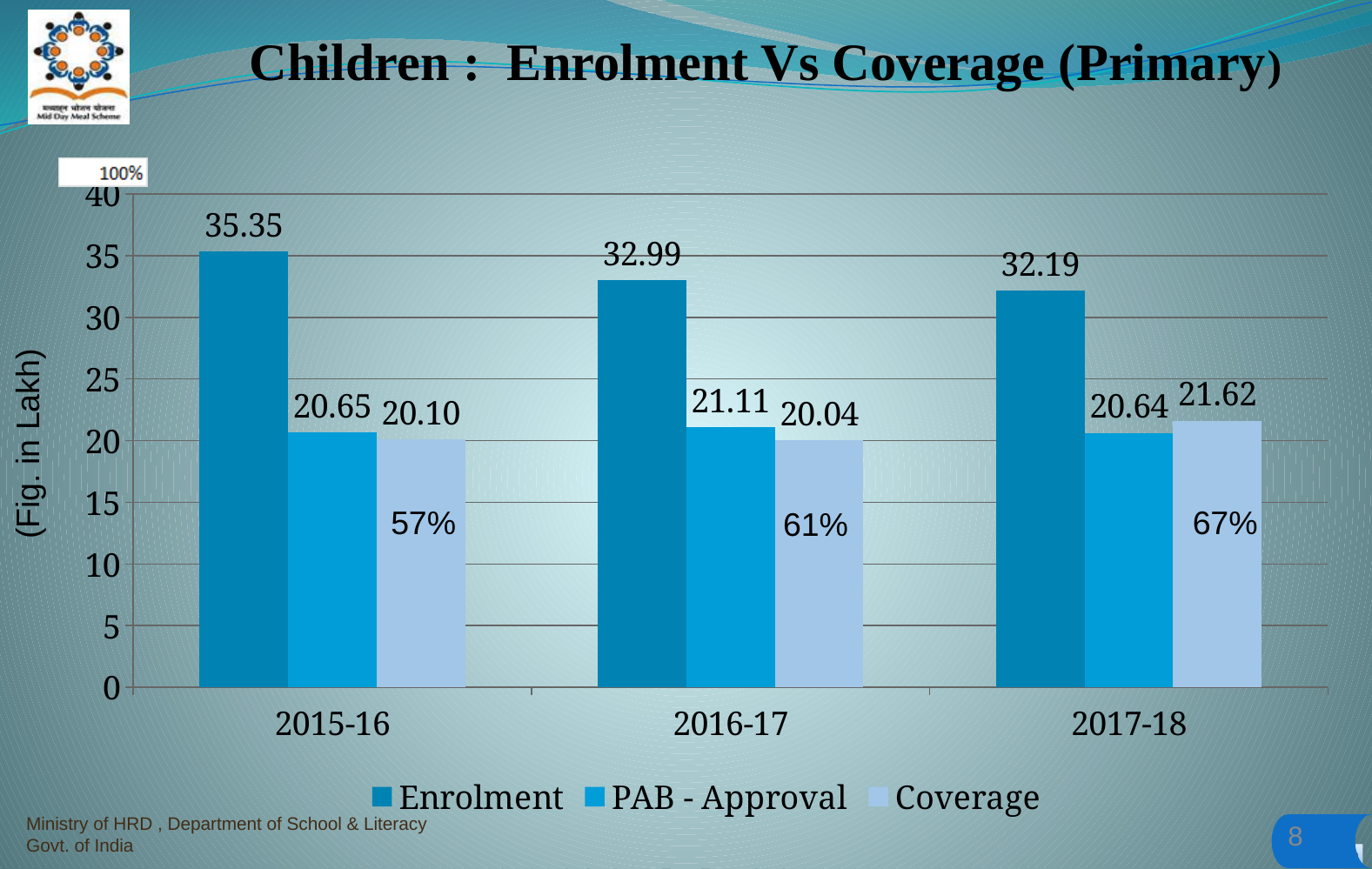
What is the Coverage value for 2017-18? 21.62 What is the difference between Enrolment and Coverage in 2017-18? 10.57 What kind of chart is shown on the slide? Bar chart How many series does the legend list? 3 What is the Enrolment value for 2015-16? 35.35 How many years are shown on the x axis? 3 Which is larger in 2017-18, PAB - Approval or Coverage? Coverage What is the PAB - Approval value for 2016-17? 21.11 Which year has the lowest Coverage value? 2016-17 Which year has the highest Enrolment value? 2015-16 What percentage is printed on the Coverage bar for 2016-17? 61% Does the Enrolment value rise or fall from 2015-16 to 2017-18? Fall